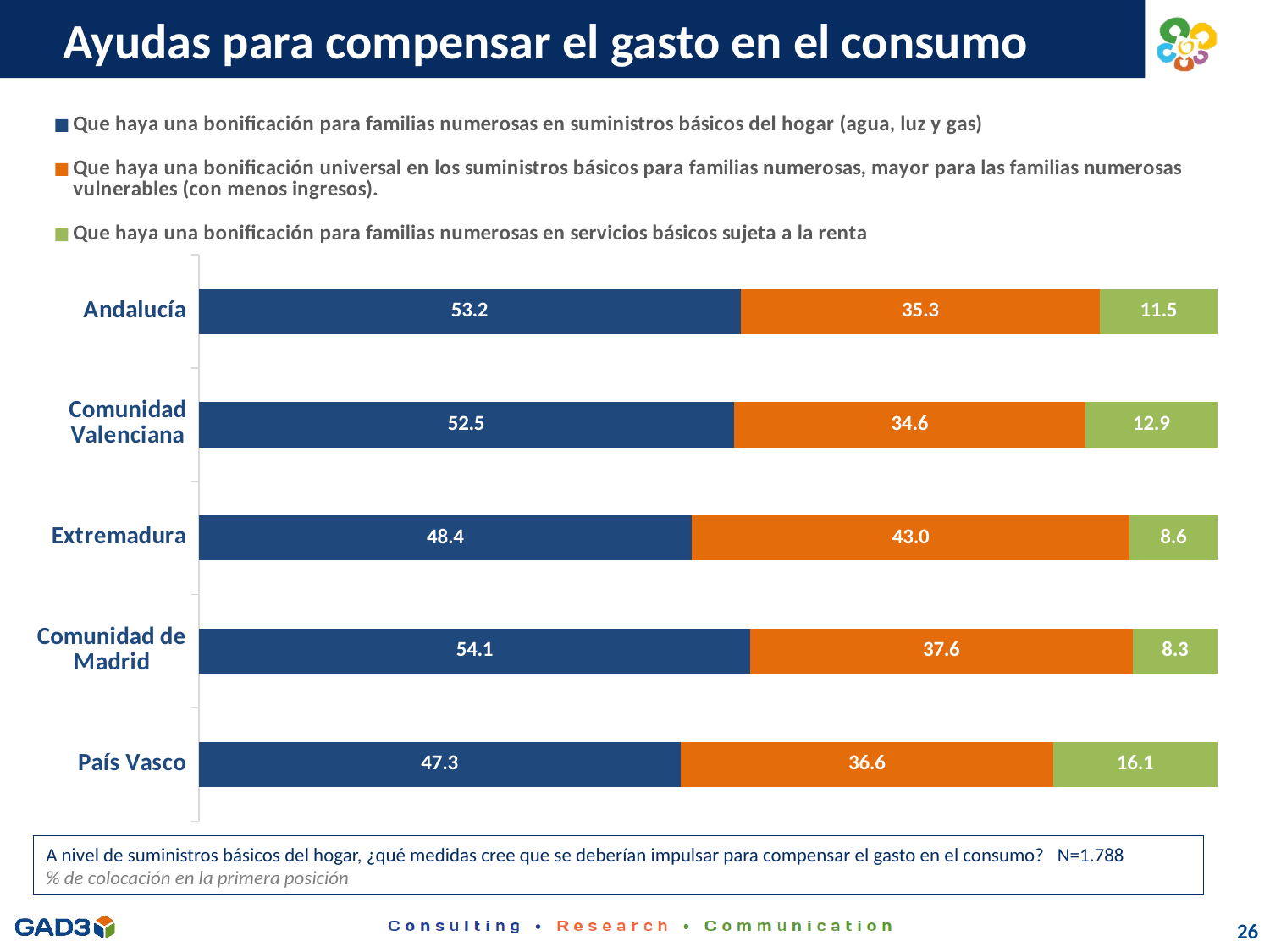
How many regions are shown in the chart? 5 Which region has the highest value for the blue series (bonificación en suministros básicos del hogar)? Comunidad de Madrid How many series does the legend list? 3 What is the value of the orange series (bonificación universal) for Extremadura? 43.0 What is the value of the green series (bonificación sujeta a la renta) for País Vasco? 16.1 Which region has the lowest value for the green series (bonificación sujeta a la renta)? Comunidad de Madrid What kind of chart is shown on the slide? Stacked bar chart What is the difference between the orange series values for Extremadura and Andalucía? 7.7 What is the total of the stacked bar for País Vasco? 100.0 What is the sample size (N) stated on the slide? N=1.788 What is the value of the blue series (bonificación para familias numerosas en suministros básicos del hogar) for Andalucía? 53.2 Which is larger: the green series value for Comunidad Valenciana or for Andalucía? Comunidad Valenciana